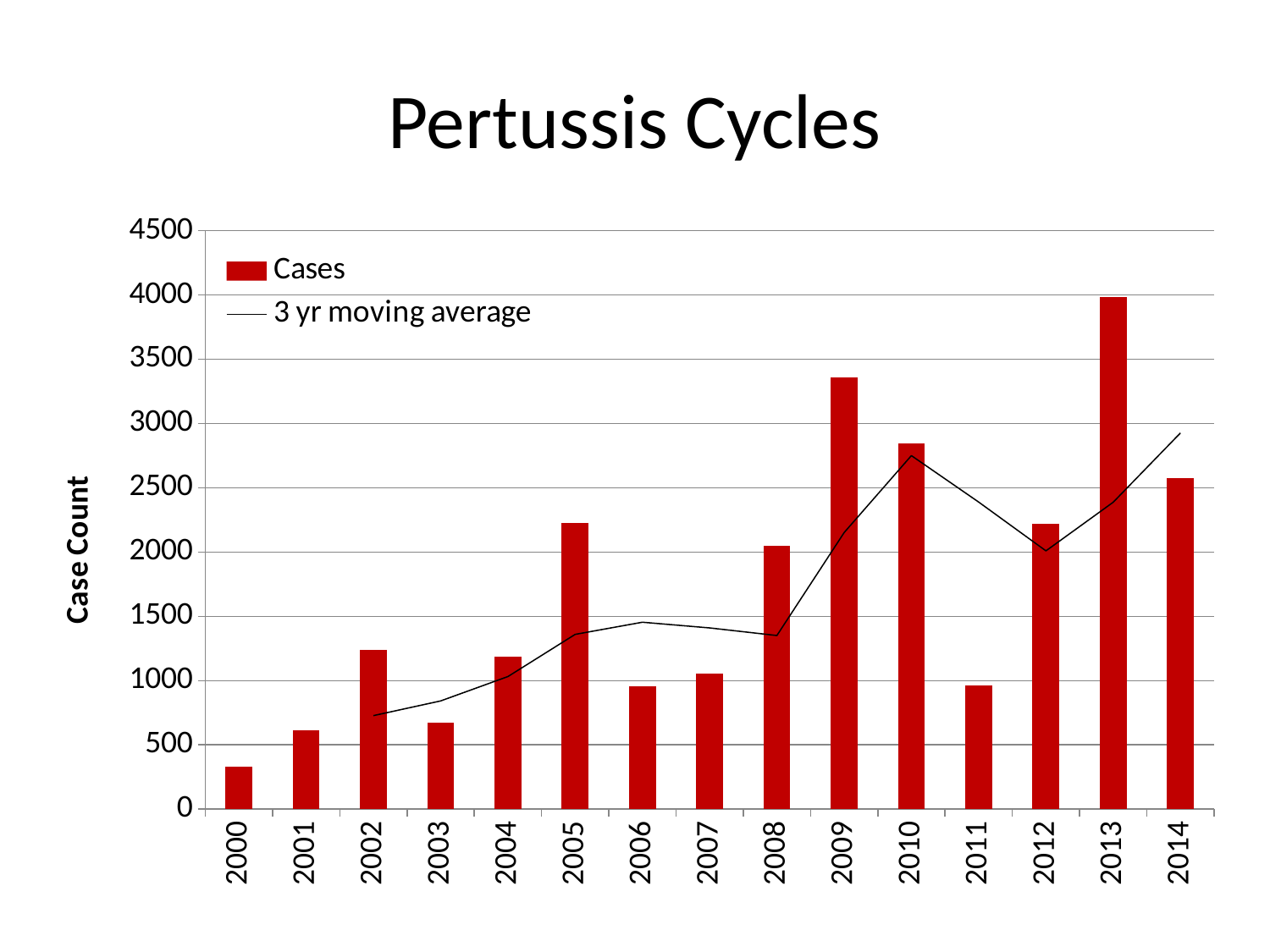
What kind of chart is used to show the Cases series? bar chart Is the number of cases in 2000 greater or less than 500? less Which year has more cases, 2005 or 2006? 2005 Which year has the lowest number of cases? 2000 Which year has the highest number of cases? 2013 What is the label of the y axis? Case Count Which year has more cases, 2009 or 2010? 2009 Is the number of cases in 2009 greater or less than 3000? greater How many series does the legend list? 2 Is the number of cases in 2013 greater or less than 3500? greater What is the title of the chart? Pertussis Cycles How many years are shown on the x axis? 15